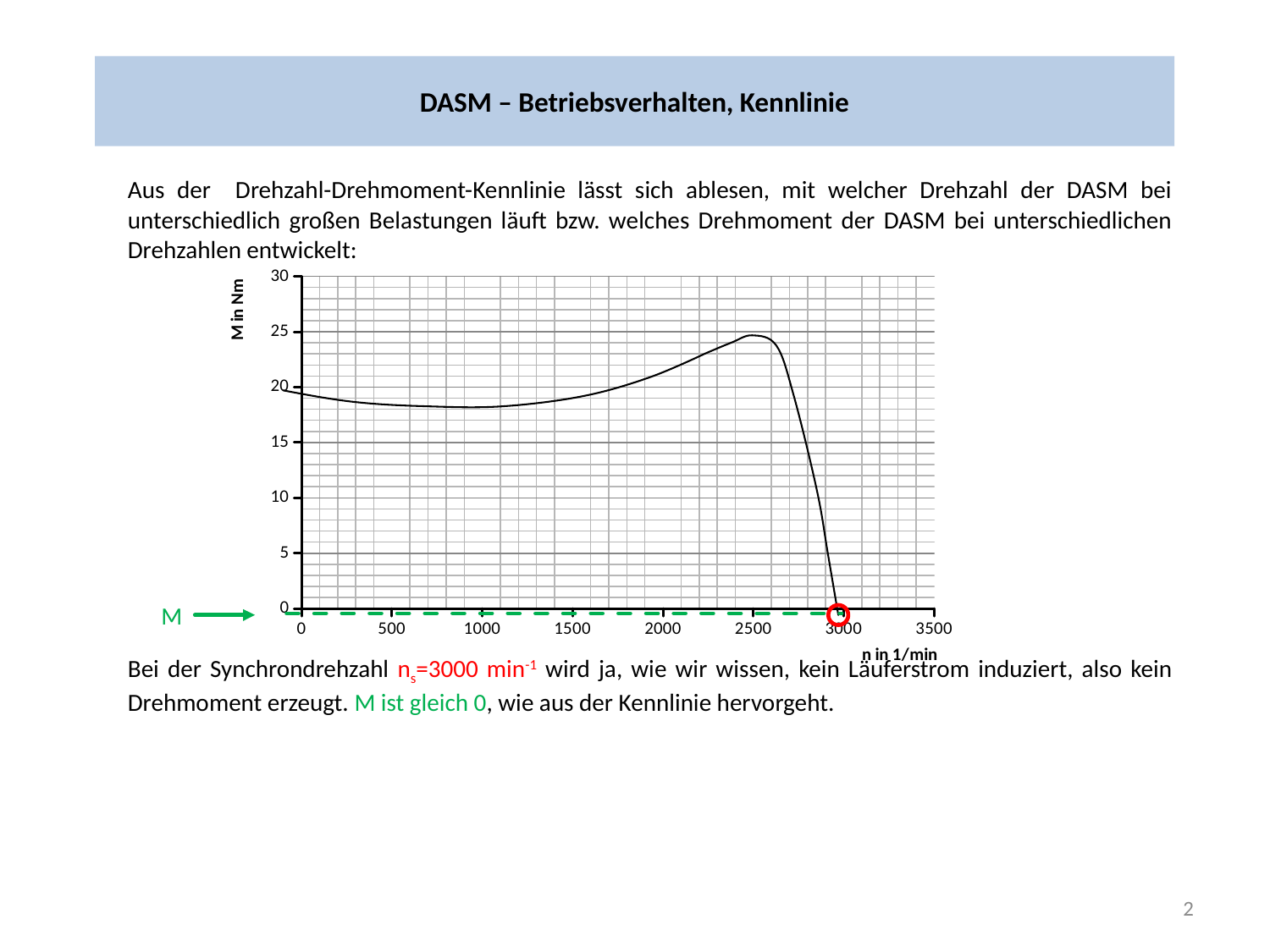
Does the torque M rise or fall as n increases from 2500 to 3000? fall What is the label of the horizontal axis of the chart? n in 1/min What is the torque M at n = 3000 1/min according to the chart? 0 Does the torque M rise or fall as n increases from 1000 to 2500? rise Is the value of M at n = 1000 greater or less than 20 Nm? less What is the label of the vertical axis of the chart? M in Nm Which is larger, the torque M at n = 2500 or at n = 1000? n = 2500 Is the value of M at n = 2500 greater or less than 20 Nm? greater Is the value of M at n = 2800 greater or less than 20 Nm? less What kind of chart is shown on the slide? line chart